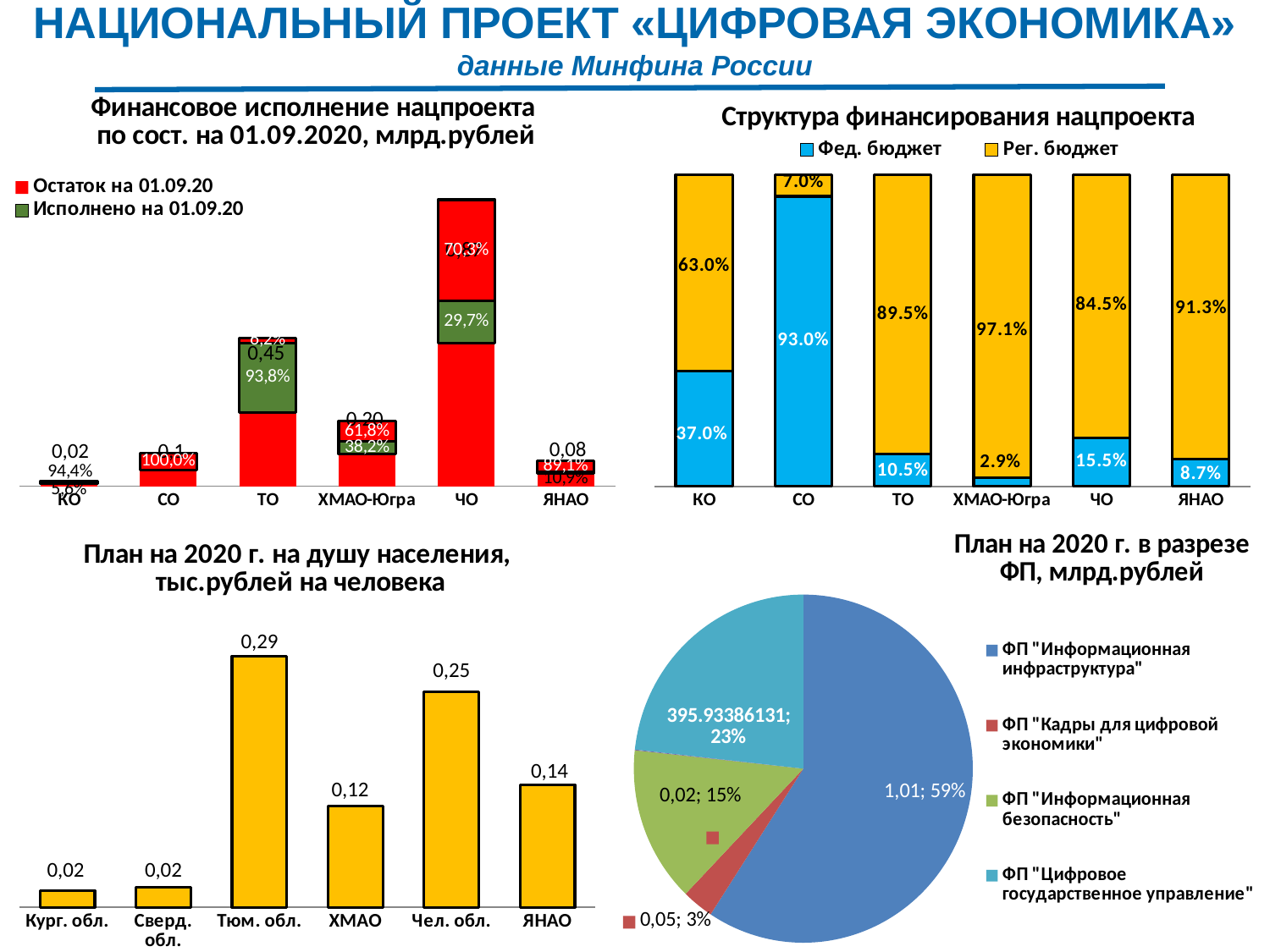
In the chart 'План на 2020 г. на душу населения, тыс.рублей на человека', what is the difference between the values for Чел. обл. and ХМАО? 0,13 In the chart 'Финансовое исполнение нацпроекта по сост. на 01.09.2020, млрд.рублей', what percentage is labelled Исполнено for ТО? 93,8% In the pie chart 'План на 2020 г. в разрезе ФП, млрд.рублей', what share does ФП "Информационная инфраструктура" have? 59% In the chart 'План на 2020 г. на душу населения, тыс.рублей на человека', which category has the highest value? Тюм. обл. In the chart 'Структура финансирования нацпроекта', how many series does the legend list? 2 In the chart 'Структура финансирования нацпроекта', what is the Фед. бюджет share for СО? 93.0% In the chart 'Финансовое исполнение нацпроекта по сост. на 01.09.2020, млрд.рублей', which region has the tallest bar? ЧО In the chart 'Структура финансирования нацпроекта', which region has the highest Рег. бюджет share? ХМАО-Югра What type of chart is 'План на 2020 г. в разрезе ФП, млрд.рублей'? Pie chart In the chart 'Структура финансирования нацпроекта', is the Фед. бюджет share larger for КО or for ЧО? КО In the chart 'План на 2020 г. на душу населения, тыс.рублей на человека', what is the value for Тюм. обл.? 0,29 In the chart 'План на 2020 г. на душу населения, тыс.рублей на человека', how many categories are shown? 6